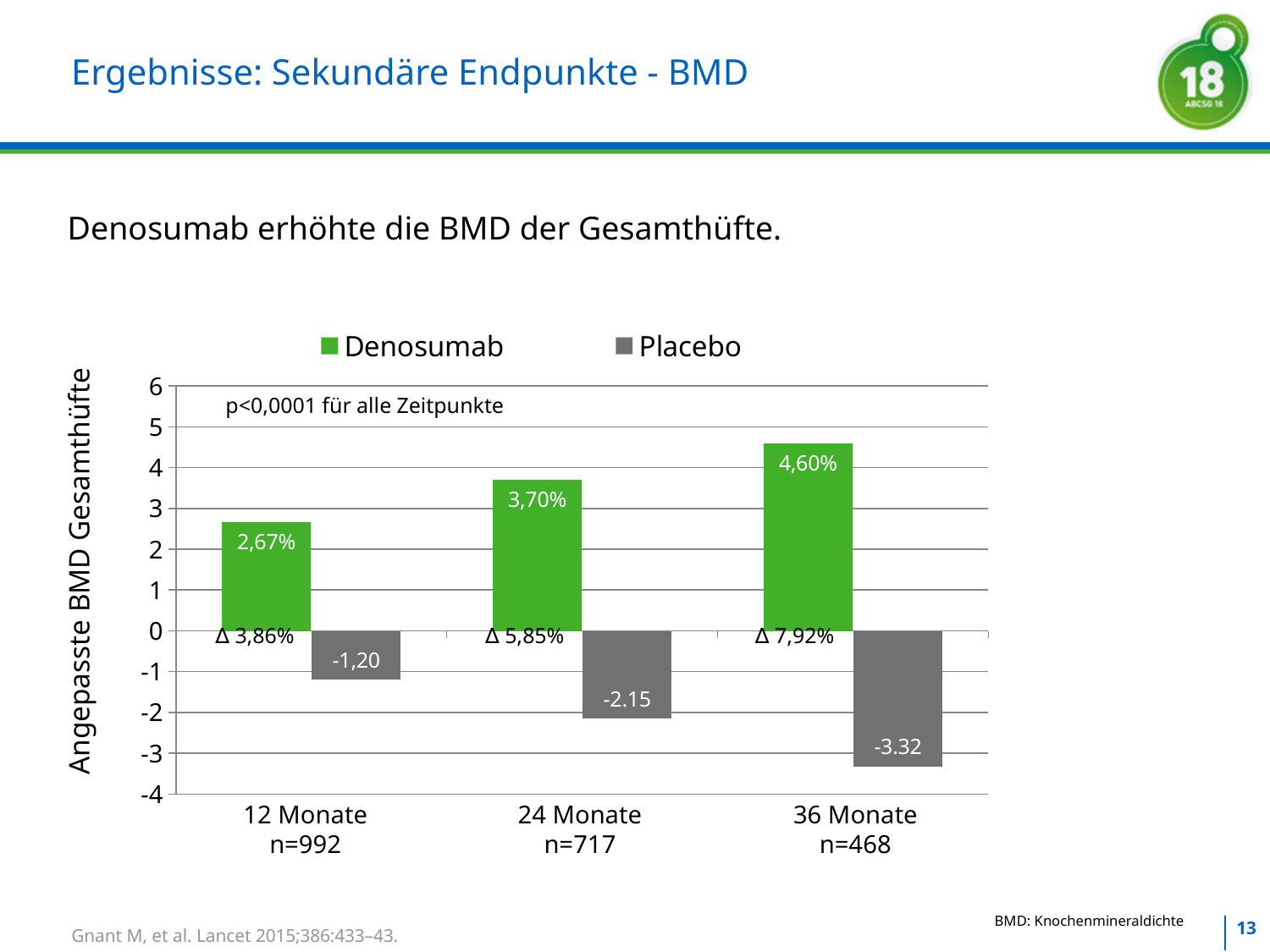
Is the Denosumab value at 36 Monate greater or less than 4? greater Do the Denosumab values rise or fall from 12 Monate to 36 Monate? rise Which is larger, the Denosumab value at 24 Monate or at 36 Monate? 36 Monate What is the Placebo value at 36 Monate? -3.32 What is the Placebo value at 12 Monate? -1,20 At which time point is the Placebo value lowest? 36 Monate What kind of chart is shown on the slide? bar chart What is the Denosumab value at 12 Monate? 2,67% How many series does the legend list? 2 At which time point is the Denosumab value highest? 36 Monate How many time points are shown on the x axis? 3 What is the Denosumab value at 24 Monate? 3,70%